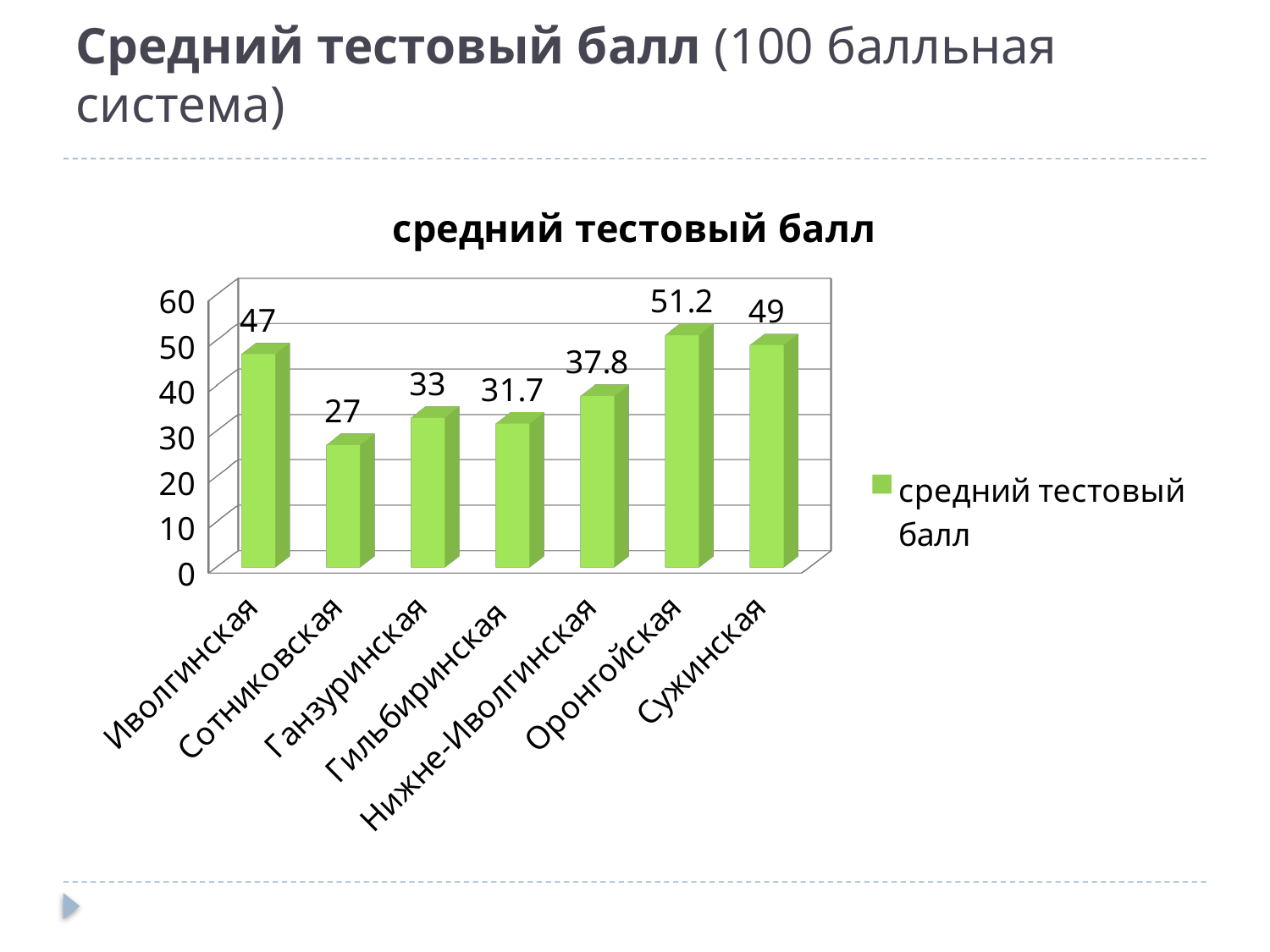
What is the average test score for Нижне-Иволгинская? 37.8 What is the title of the chart? средний тестовый балл Which school has the lowest average test score? Сотниковская How many schools are shown on the chart? 7 Is the value for Сотниковская greater or less than 30? less What is the average test score for Сотниковская? 27 What is the average test score for Иволгинская? 47 What is the difference between the average test scores of Оронгойская and Сужинская? 2.2 What is the average test score for Гильбиринская? 31.7 Which school has the highest average test score? Оронгойская Which has a higher average test score, Ганзуринская or Гильбиринская? Ганзуринская What kind of chart is shown on the slide? bar chart